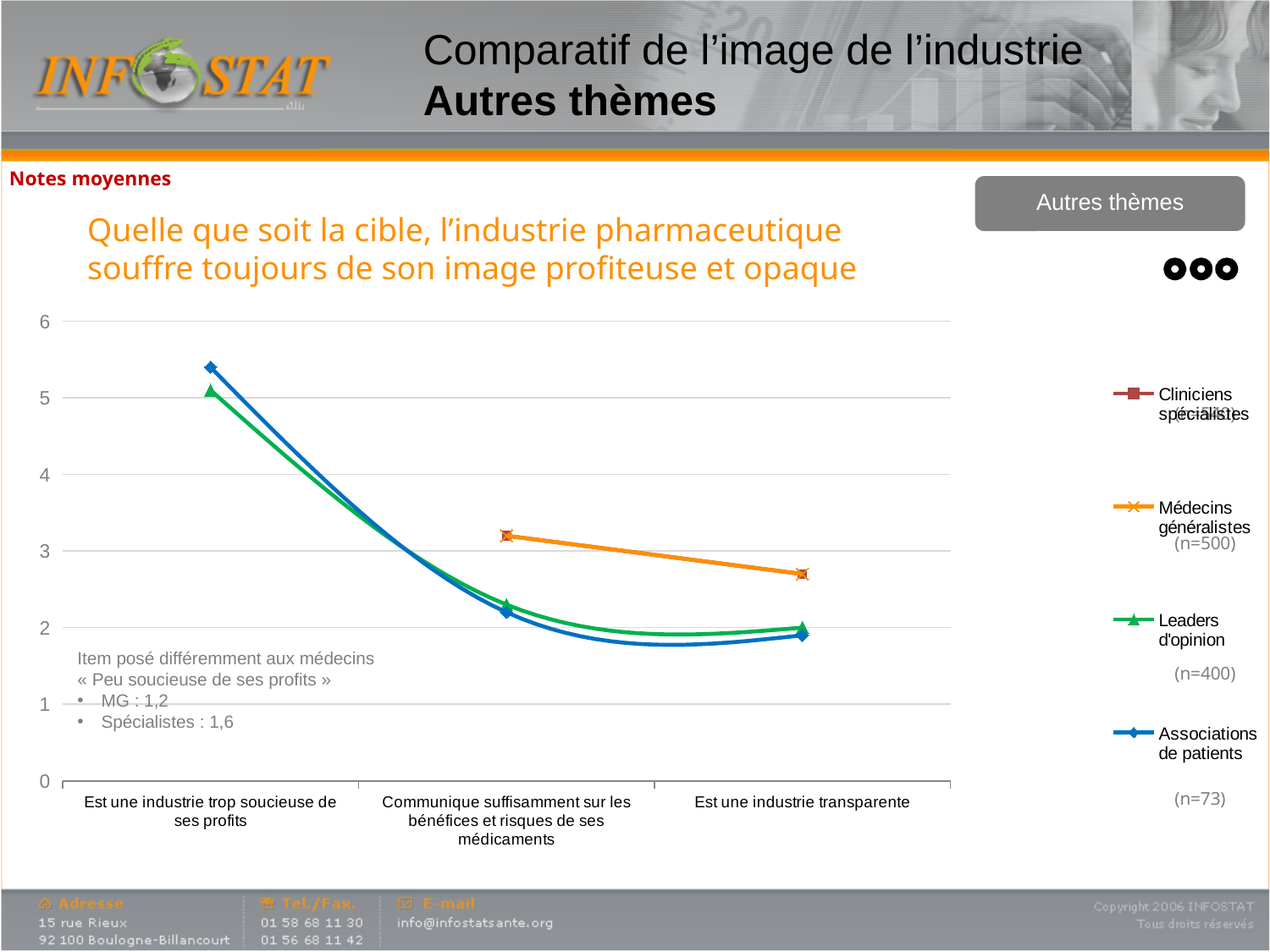
Is the value for Médecins généralistes on "Est une industrie transparente" greater or less than 3? less Is the value for Leaders d'opinion on "Communique suffisamment sur les bénéfices et risques de ses médicaments" greater or less than 3? less How many series does the chart legend list? 4 According to the legend, what is the sample size (n) for Associations de patients? n=73 How many categories are shown on the x axis of the chart? 3 Is the value for Associations de patients on "Est une industrie trop soucieuse de ses profits" greater or less than 5? greater What kind of chart is shown on the slide? line chart For "Est une industrie transparente", which is higher: Médecins généralistes or Leaders d'opinion? Médecins généralistes According to the legend, what is the sample size (n) for Médecins généralistes? n=500 Which series has the highest value for "Communique suffisamment sur les bénéfices et risques de ses médicaments"? Cliniciens spécialistes and Médecins généralistes (tied) Do the values for Associations de patients rise or fall from the first category to the last along the x axis? fall